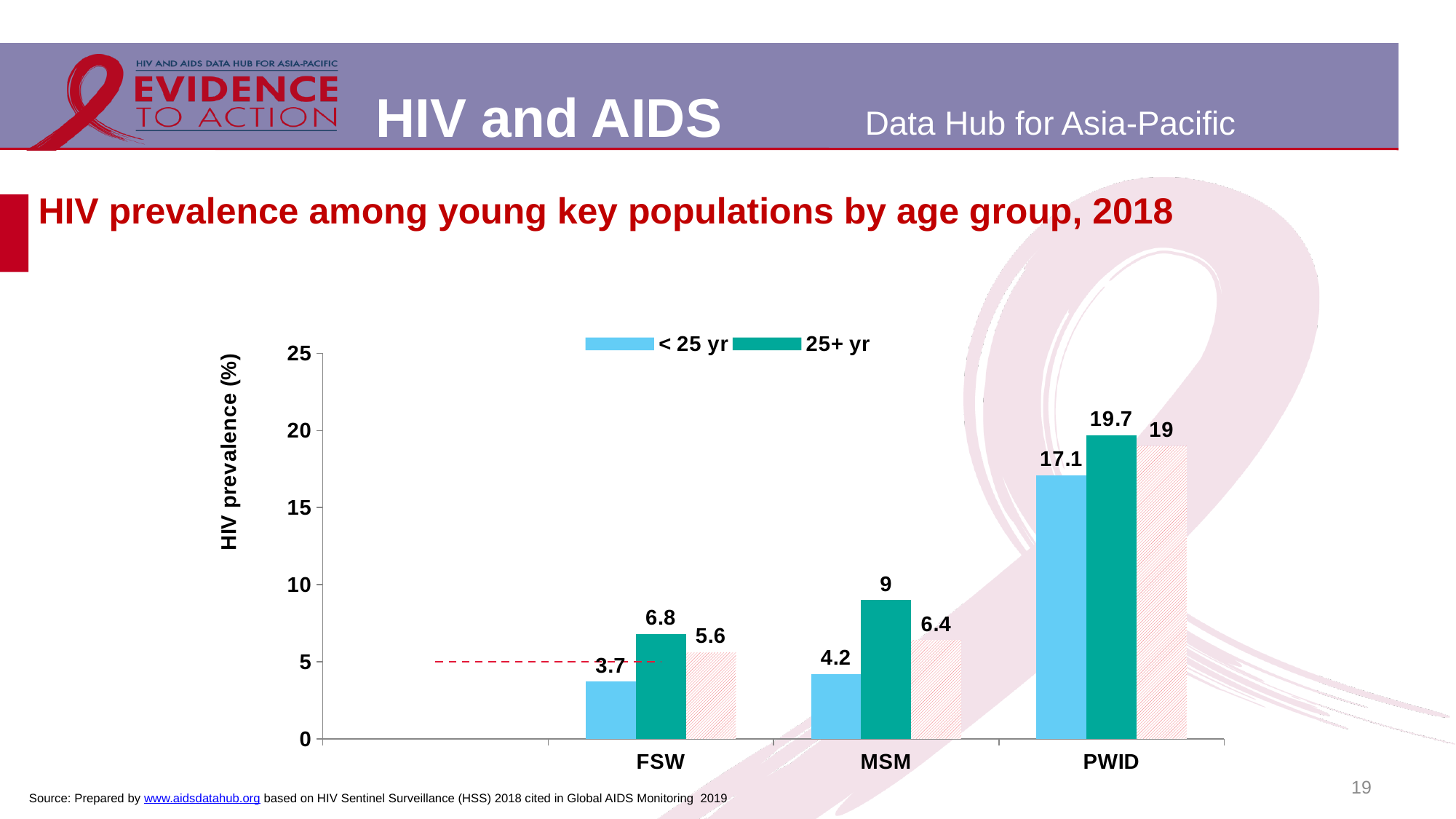
How many key population categories are shown on the x axis? 3 What kind of chart is shown on the slide? bar chart What is the difference between the 25+ yr and < 25 yr HIV prevalence for MSM? 4.8 Is the 25+ yr value for FSW greater or less than 5? greater What is the HIV prevalence for FSW under 25 years? 3.7 What is the HIV prevalence for MSM aged 25+ years? 9 What is the HIV prevalence for PWID under 25 years? 17.1 Which is larger: the < 25 yr value for MSM or the < 25 yr value for FSW? MSM Which key population has the highest HIV prevalence in the 25+ yr series? PWID How many series does the legend list? 2 Which key population has the lowest HIV prevalence in the < 25 yr series? FSW What is the difference between the 25+ yr and < 25 yr HIV prevalence for PWID? 2.6